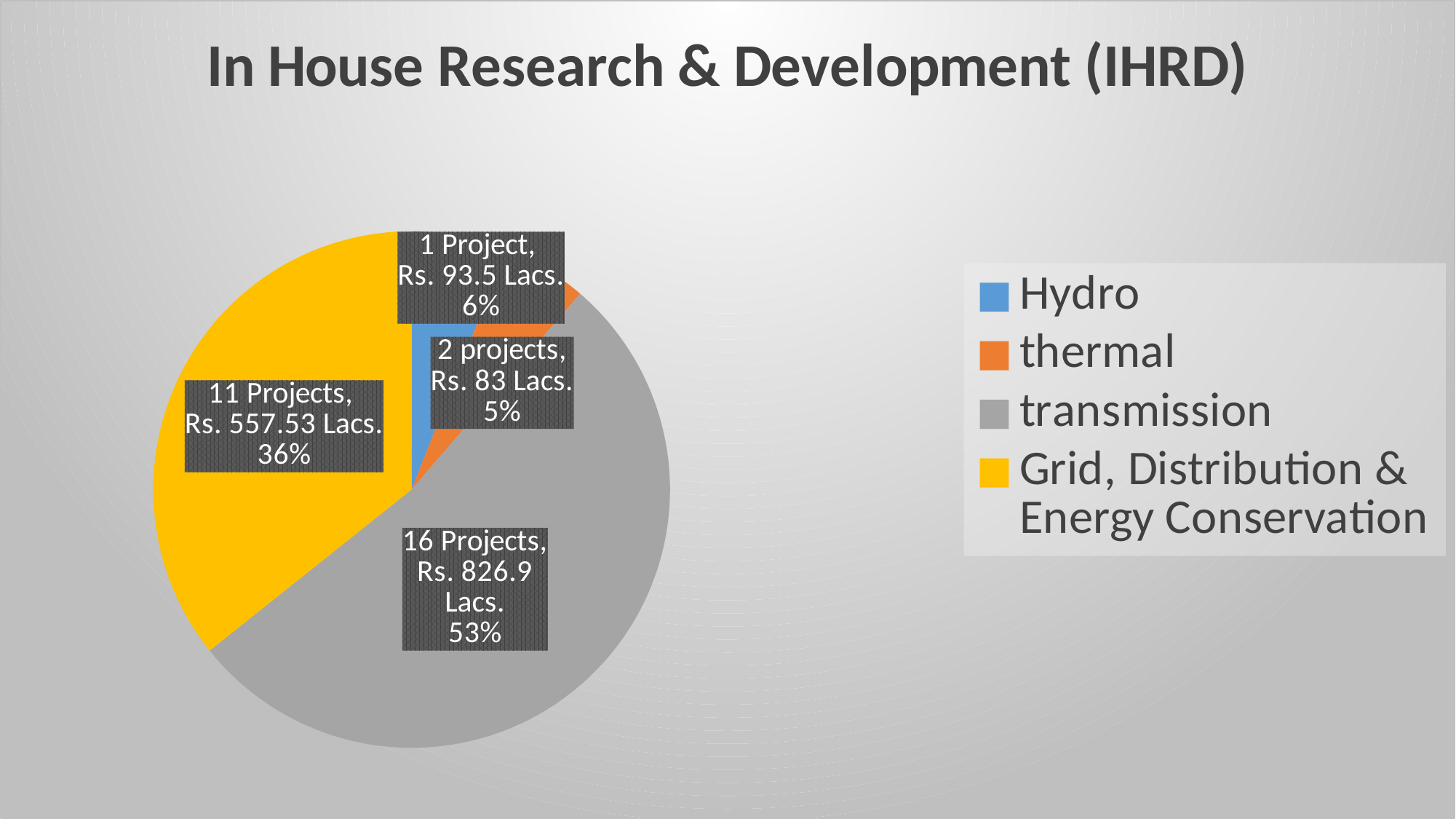
What share of the pie does Hydro take? 6% What share of the pie does Grid, Distribution & Energy Conservation take? 36% What share of the pie does transmission take? 53% What is the amount shown for Grid, Distribution & Energy Conservation? Rs. 557.53 Lacs What is the title of the chart? In House Research & Development (IHRD) How many projects are shown for transmission? 16 Projects What kind of chart is shown on the slide? pie chart Which is larger, the share for Hydro or the share for Grid, Distribution & Energy Conservation? Grid, Distribution & Energy Conservation What colour represents thermal in the chart? orange Which category has the largest slice of the pie? transmission How many categories does the legend list? 4